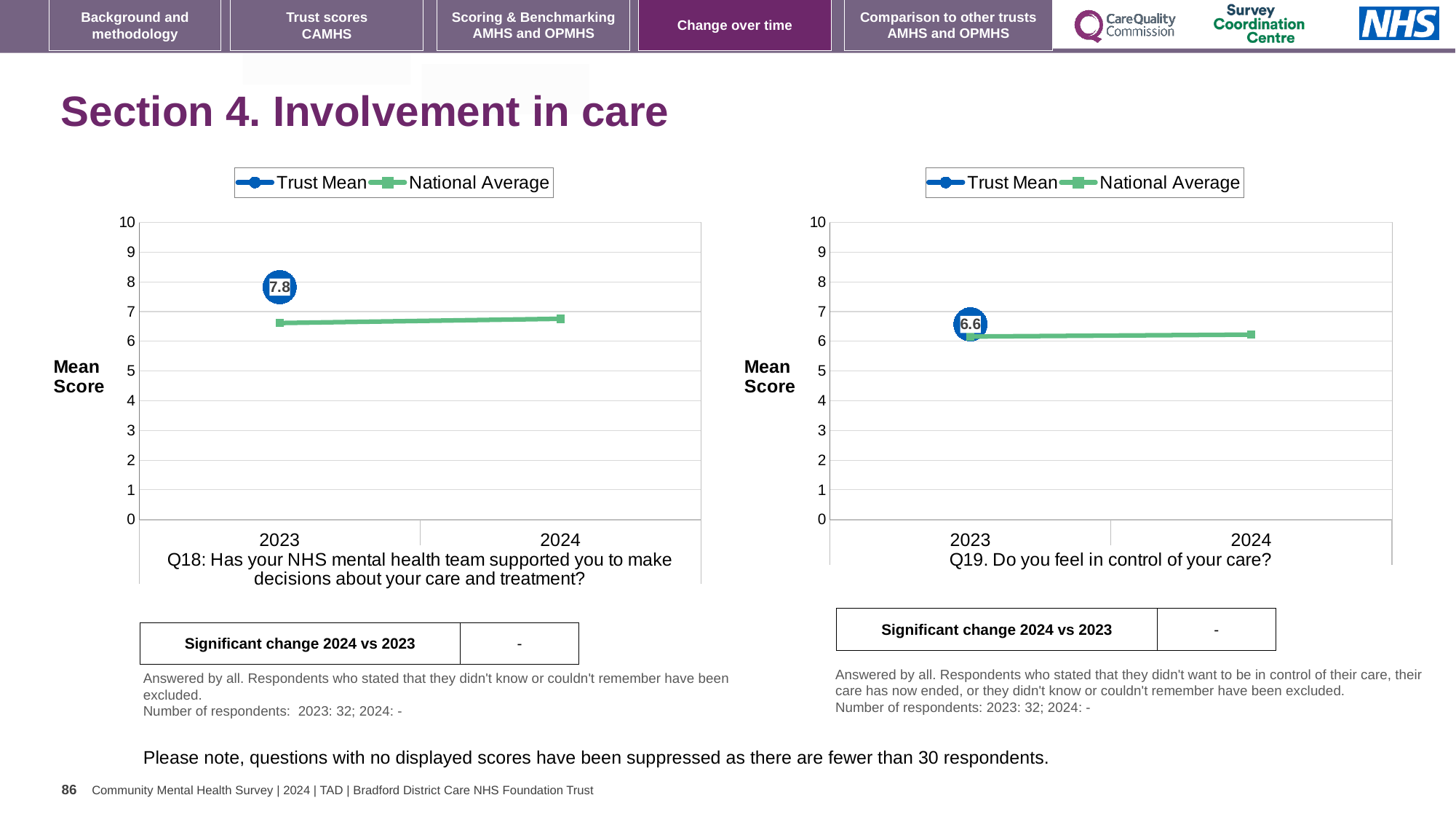
What question is the right chart about? Q19. Do you feel in control of your care? What are the two series named in the legend of the left chart? Trust Mean and National Average In the right chart (Q19), is the National Average value for 2024 greater or less than 5? greater In the right chart (Q19), what is the Trust Mean score for 2023? 6.6 In the left chart (Q18), does the National Average rise or fall from 2023 to 2024? Rise How many years are shown on the x axis of the left chart (Q18)? 2 In the left chart (Q18), what is the Trust Mean score for 2023? 7.8 How many series does the legend of the right chart (Q19) list? 2 What kind of chart is the left chart (Q18)? Line chart In the left chart (Q18), is the National Average value for 2024 greater or less than 8? less In the left chart (Q18), which is higher for 2023: the Trust Mean or the National Average? Trust Mean In the right chart (Q19), is the Trust Mean value for 2023 greater or less than 6? greater